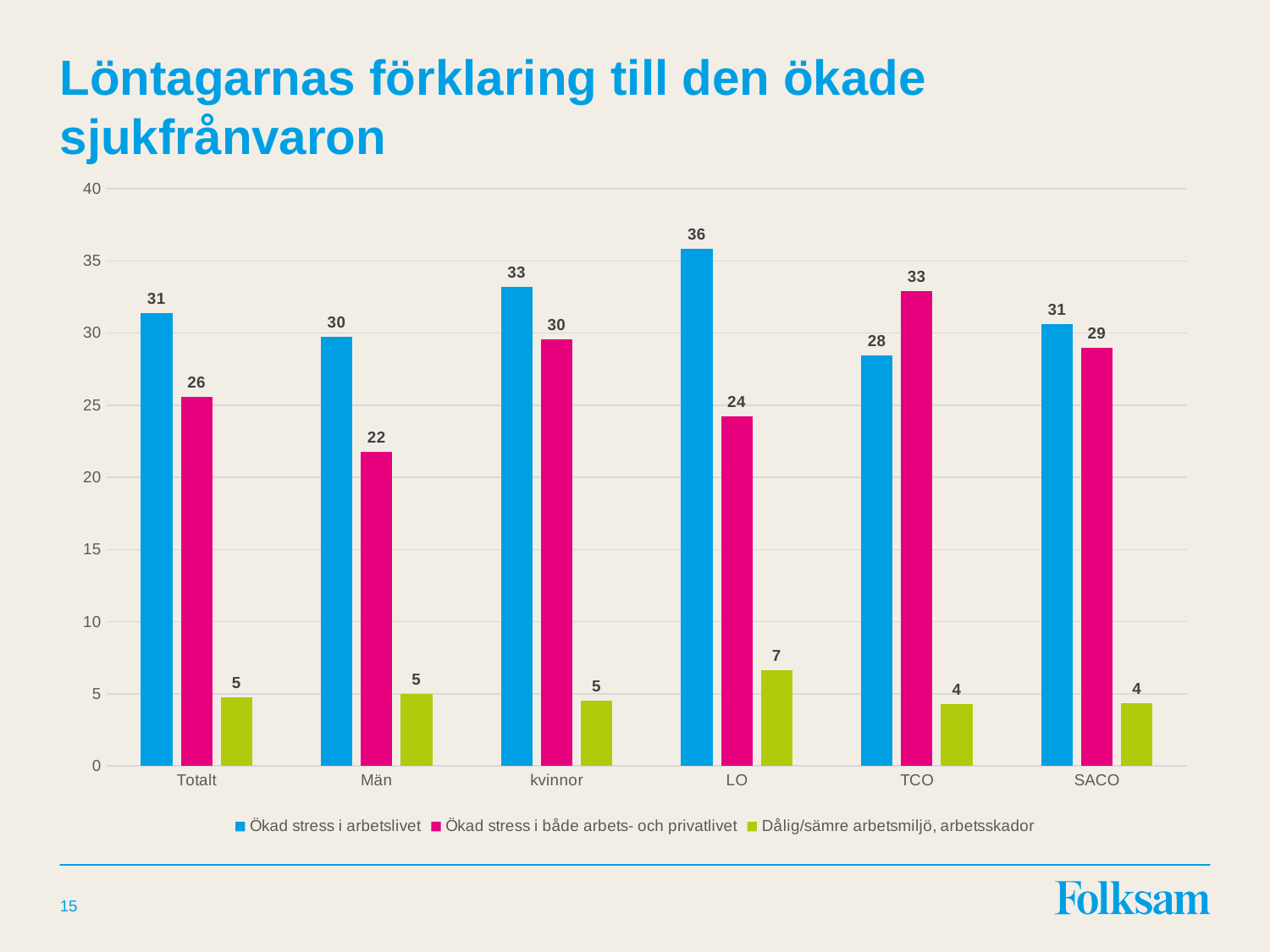
What is the value for 'Dålig/sämre arbetsmiljö, arbetsskador' for LO? 7 How many categories are shown on the x axis? 6 How many series does the legend list? 3 What is the value for 'Ökad stress i både arbets- och privatlivet' for Män? 22 Which category has the highest value for 'Ökad stress i arbetslivet'? LO What is the difference between 'Ökad stress i arbetslivet' and 'Ökad stress i både arbets- och privatlivet' for LO? 12 Is the value for 'Ökad stress i arbetslivet' for kvinnor greater or less than 30? greater What kind of chart is shown on the slide? bar chart Which category has the lowest value for 'Ökad stress i både arbets- och privatlivet'? Män What is the value for 'Ökad stress i arbetslivet' for LO? 36 What is the title of the slide? Löntagarnas förklaring till den ökade sjukfrånvaron For TCO, which is larger: 'Ökad stress i arbetslivet' or 'Ökad stress i både arbets- och privatlivet'? Ökad stress i både arbets- och privatlivet